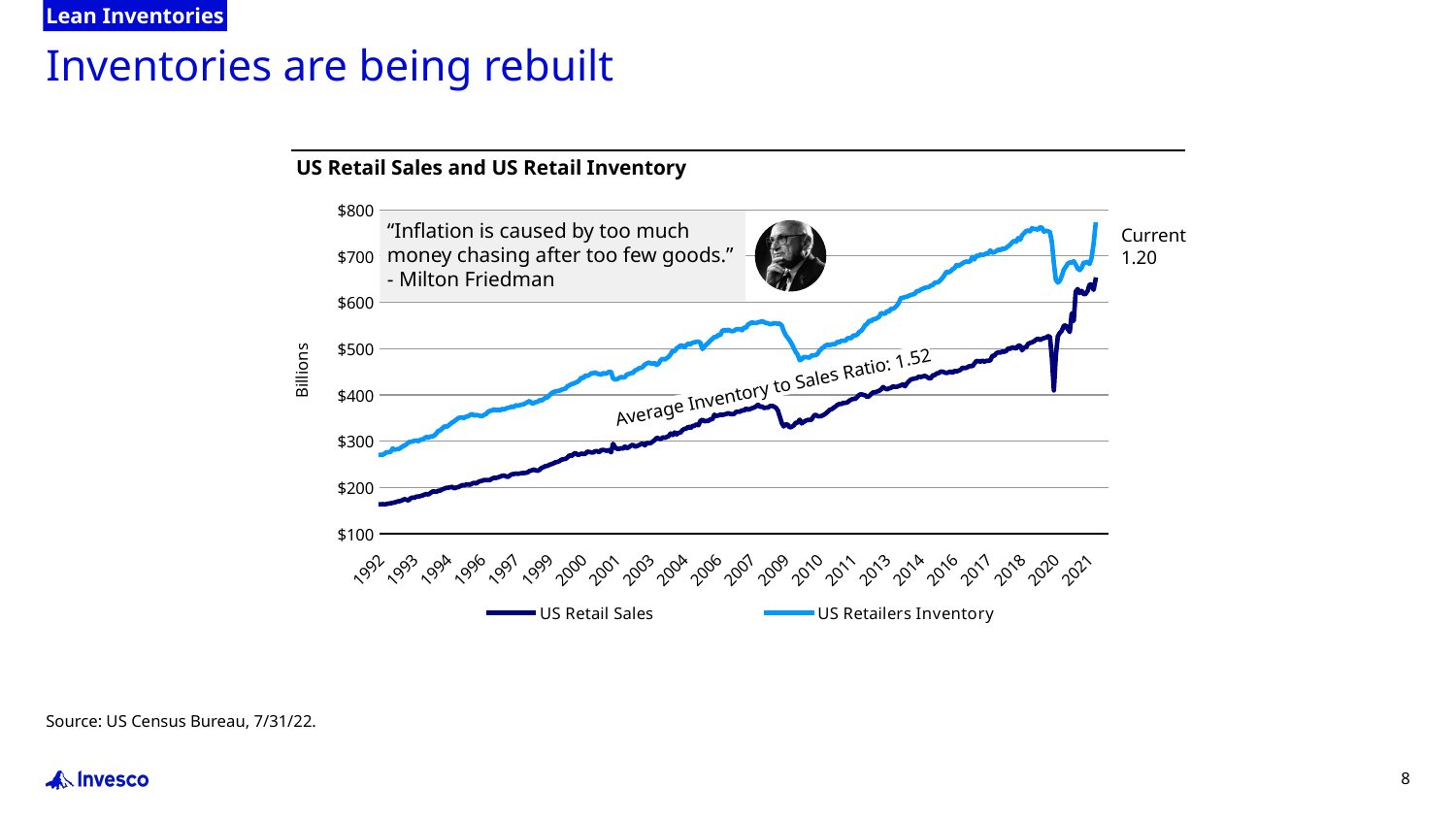
Is the value for US Retail Sales at the end of the chart in 2021 greater or less than $600? greater Is the value for US Retail Sales at the start of the chart in 1992 greater or less than $200? less Which series is plotted higher on the chart across the whole period, US Retail Sales or US Retailers Inventory? US Retailers Inventory Is the value for US Retailers Inventory at the start of the chart in 1992 greater or less than $300? less How many series does the chart's legend list? 2 What kind of chart is shown on the slide? Line chart What is the current inventory to sales ratio printed on the chart? 1.20 Overall, does the US Retail Sales line rise or fall from 1992 to 2021? Rise What is the title of the chart? US Retail Sales and US Retail Inventory What are the two series named in the chart's legend? US Retail Sales and US Retailers Inventory What is the average inventory to sales ratio printed on the chart? 1.52